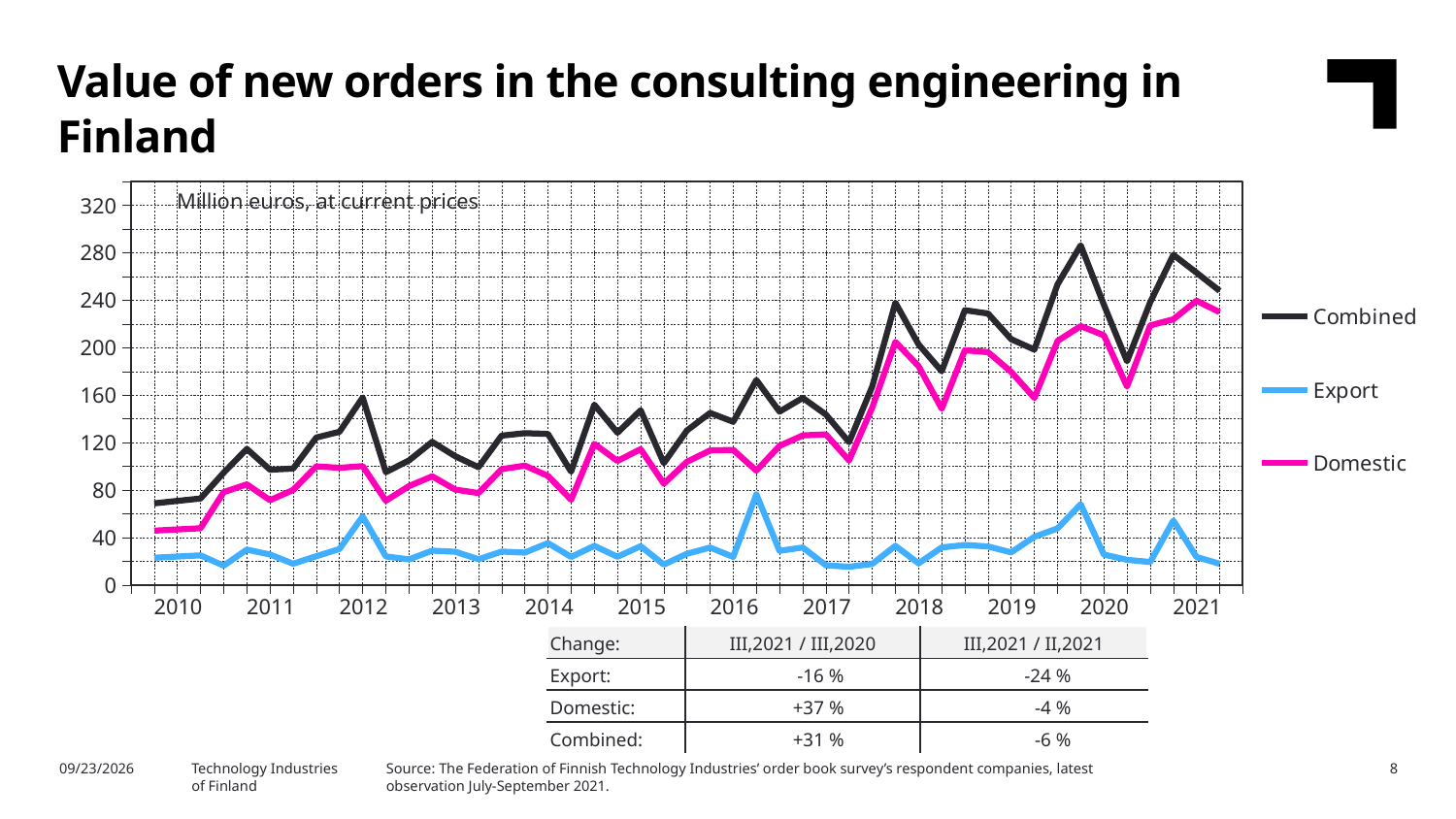
What unit is stated at the top of the chart? Million euros, at current prices What are the three series named in the legend? Combined, Export, Domestic How many series does the legend list? 3 Does the Combined series rise or fall overall from 2010 to 2021? rise What kind of chart is shown on the slide? line chart Is the value for Domestic at the end of 2021 greater or less than 200? greater According to the table below the chart, what is the Export change for III,2021 / III,2020? -16 % Is the value for Export at the start of 2010 greater or less than 40? less Is the value for Combined at the start of 2010 greater or less than 80? less Which is larger in 2021, the Combined value or the Export value? Combined Which series has the highest values throughout the chart? Combined Which series has the lowest values throughout the chart? Export